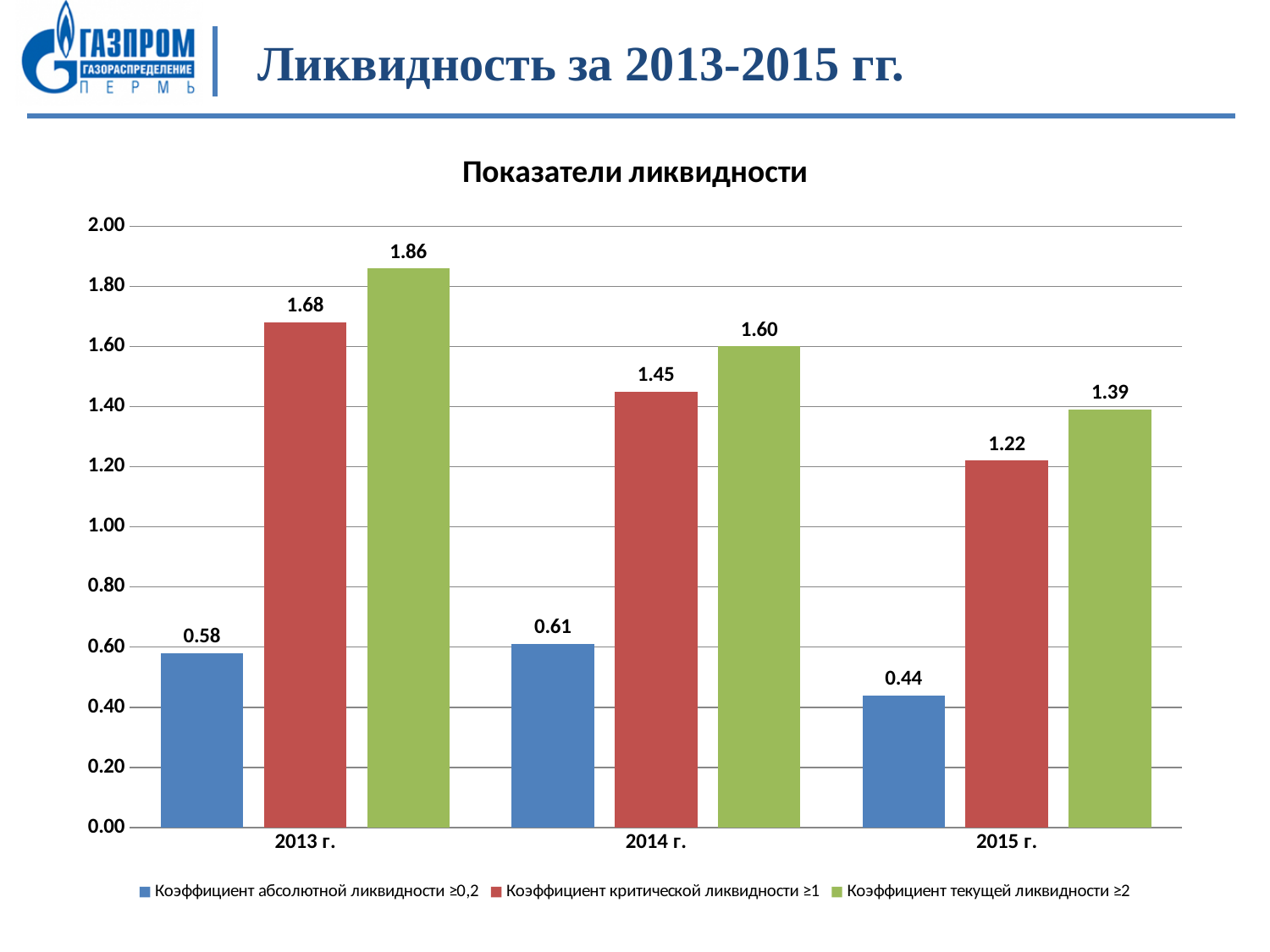
In which year is Коэффициент критической ликвидности ≥1 the highest? 2013 г. What is the value of Коэффициент текущей ликвидности ≥2 for 2013 г.? 1.86 How many years are shown on the x axis? 3 What is the difference between Коэффициент текущей ликвидности ≥2 in 2013 г. and in 2015 г.? 0.47 Is the value of Коэффициент критической ликвидности ≥1 for 2015 г. greater or less than 1.00? greater Which is larger: Коэффициент абсолютной ликвидности ≥0,2 in 2013 г. or in 2014 г.? 2014 г. What kind of chart is shown? bar chart Does Коэффициент текущей ликвидности ≥2 rise or fall from 2013 г. to 2015 г.? fall What is the value of Коэффициент абсолютной ликвидности ≥0,2 for 2015 г.? 0.44 How many series does the legend list? 3 What is the value of Коэффициент критической ликвидности ≥1 for 2014 г.? 1.45 In which year is Коэффициент абсолютной ликвидности ≥0,2 the lowest? 2015 г.